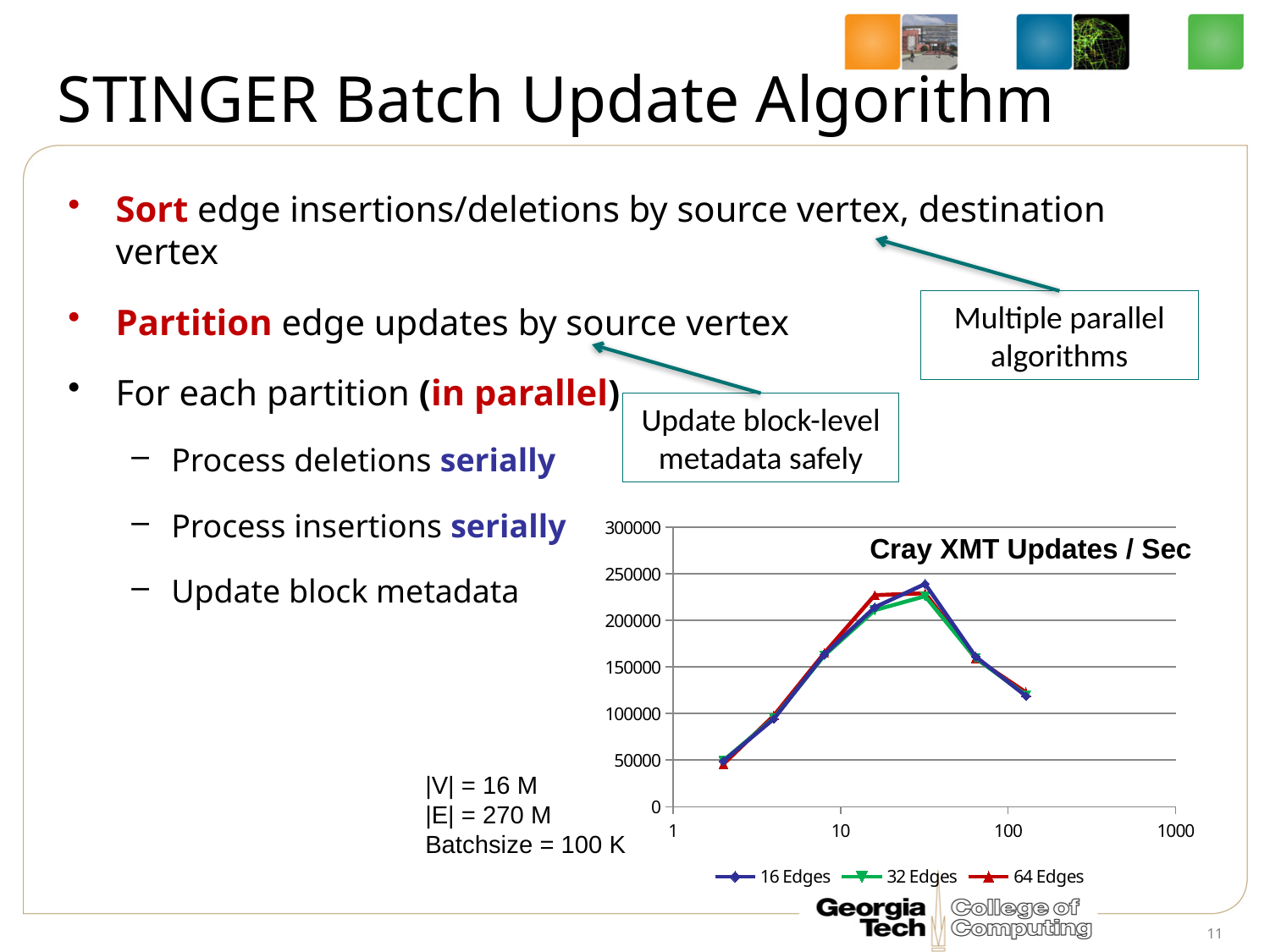
Is the peak value of the 64 Edges series greater or less than 250000? less Do the values of the 32 Edges series rise or fall as the x axis goes from 100 toward 1000? fall How many data points are plotted for the 16 Edges series? 7 What is the highest value shown on the chart's y axis? 300000 What kind of chart is shown on the slide? line chart Is the leftmost value of the 64 Edges series greater or less than 100000? less What is the title of the chart? Cray XMT Updates / Sec Do the values of the 16 Edges series rise or fall as the x axis goes from 1 toward 10? rise Is the peak value of the 16 Edges series greater or less than 200000? greater How many series does the chart's legend list? 3 What are the three series named in the chart's legend? 16 Edges, 32 Edges, 64 Edges